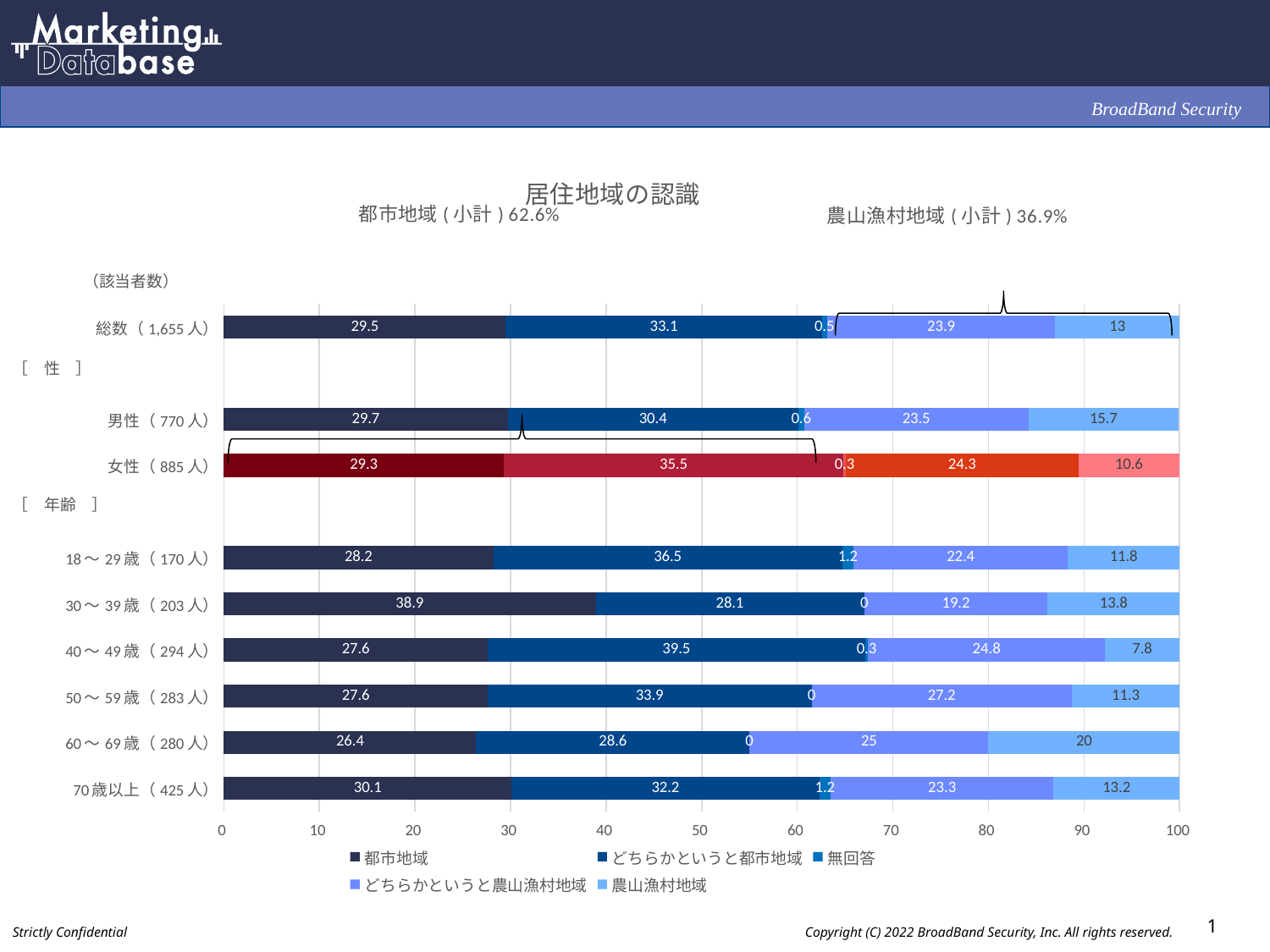
What is the difference between the 農山漁村地域 values for 男性 (770人) and 女性 (885人)? 5.1 What is the title of the chart? 居住地域の認識 What is the value of 都市地域 for 総数 (1,655人)? 29.5 How many category bars are plotted in the chart? 9 What type of chart is shown on the slide? Stacked bar chart Which category has the lowest value for 農山漁村地域? 40～49歳 (294人) Which is larger: the どちらかというと農山漁村地域 value for 50～59歳 (283人) or for 30～39歳 (203人)? 50～59歳 (283人) What is the value of どちらかというと都市地域 for 40～49歳 (294人)? 39.5 How many series does the legend list? 5 What is the 無回答 value for 70歳以上 (425人)? 1.2 Which category has the highest value for 都市地域? 30～39歳 (203人) What is the value of 農山漁村地域 for 60～69歳 (280人)? 20